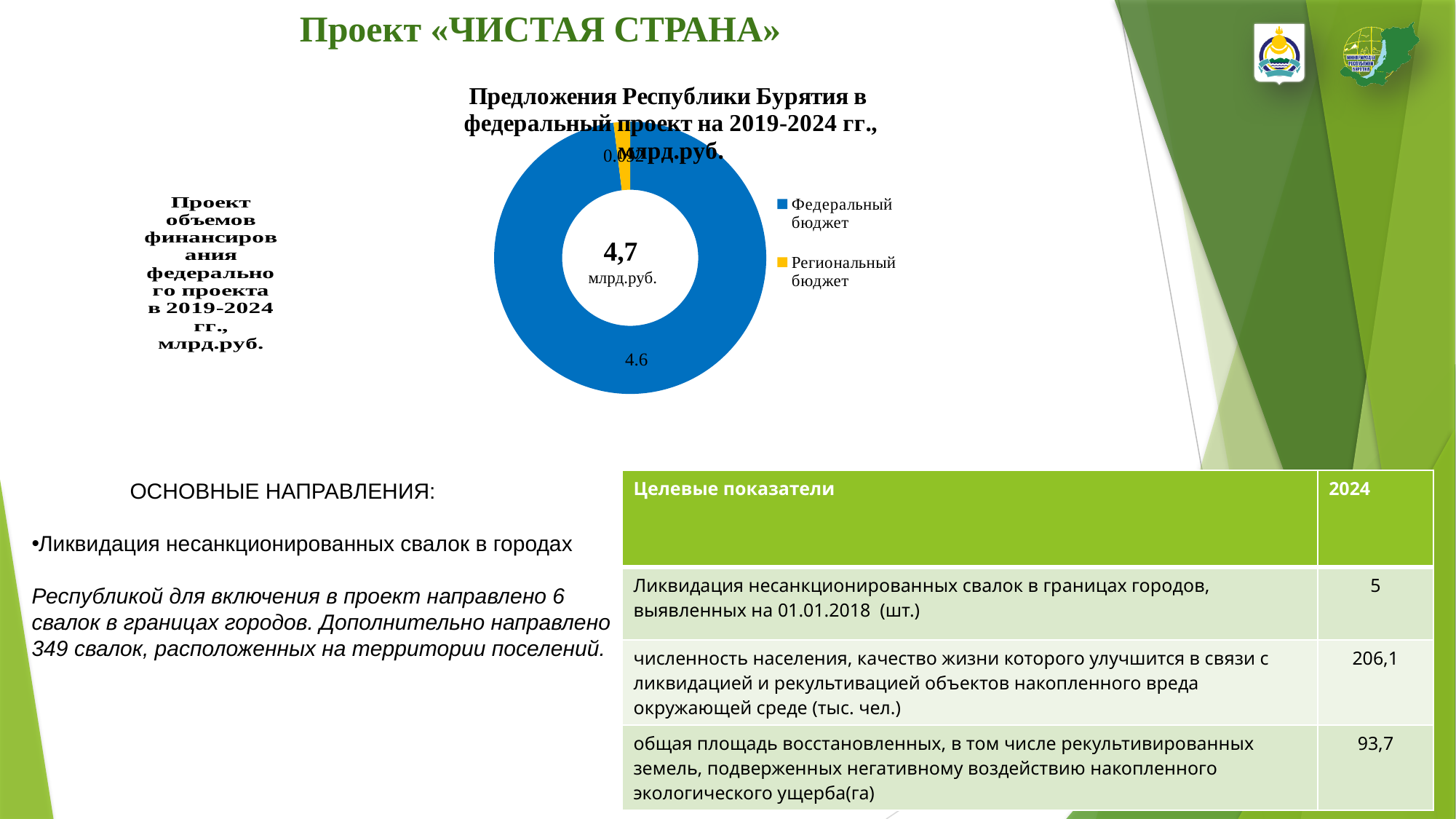
What kind of chart is shown on the slide? doughnut chart How many entries does the legend of the doughnut chart list? 2 What colour represents Федеральный бюджет in the doughnut chart? blue Which is larger in the doughnut chart, Федеральный бюджет or Региональный бюджет? Федеральный бюджет Which category has the largest slice in the doughnut chart? Федеральный бюджет What total value is printed in the centre of the doughnut chart? 4,7 млрд.руб. How many categories does the doughnut chart show? 2 What colour represents Региональный бюджет in the doughnut chart? yellow Which category has the smallest slice in the doughnut chart? Региональный бюджет What is the value for Федеральный бюджет in the doughnut chart? 4.6 Is the value for Федеральный бюджет greater or less than 4? greater